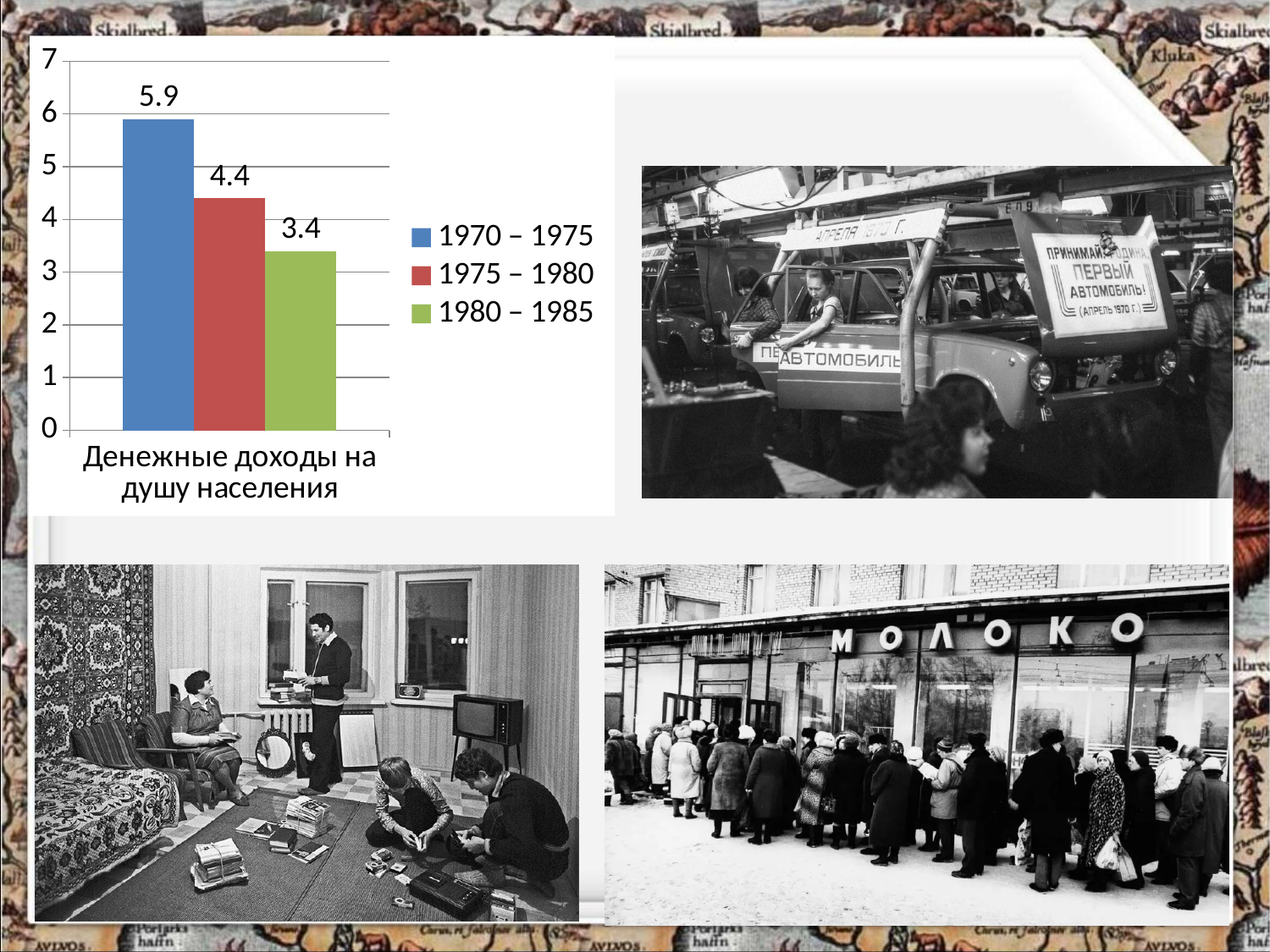
What is the value for 1980 – 1985 in the chart? 3.4 What is the difference between the values for 1970 – 1975 and 1975 – 1980? 1.5 Which period has the highest value in the chart? 1970 – 1975 What is the difference between the values for 1970 – 1975 and 1980 – 1985? 2.5 What is the value for 1975 – 1980 in the chart? 4.4 What is the value for 1970 – 1975 in the chart? 5.9 What is the category label shown under the bars of the chart? Денежные доходы на душу населения Which is larger, the value for 1975 – 1980 or the value for 1980 – 1985? 1975 – 1980 Which period has the lowest value in the chart? 1980 – 1985 How many series does the legend list? 3 Is the value for 1975 – 1980 greater or less than 4? greater What kind of chart is shown on the slide? bar chart